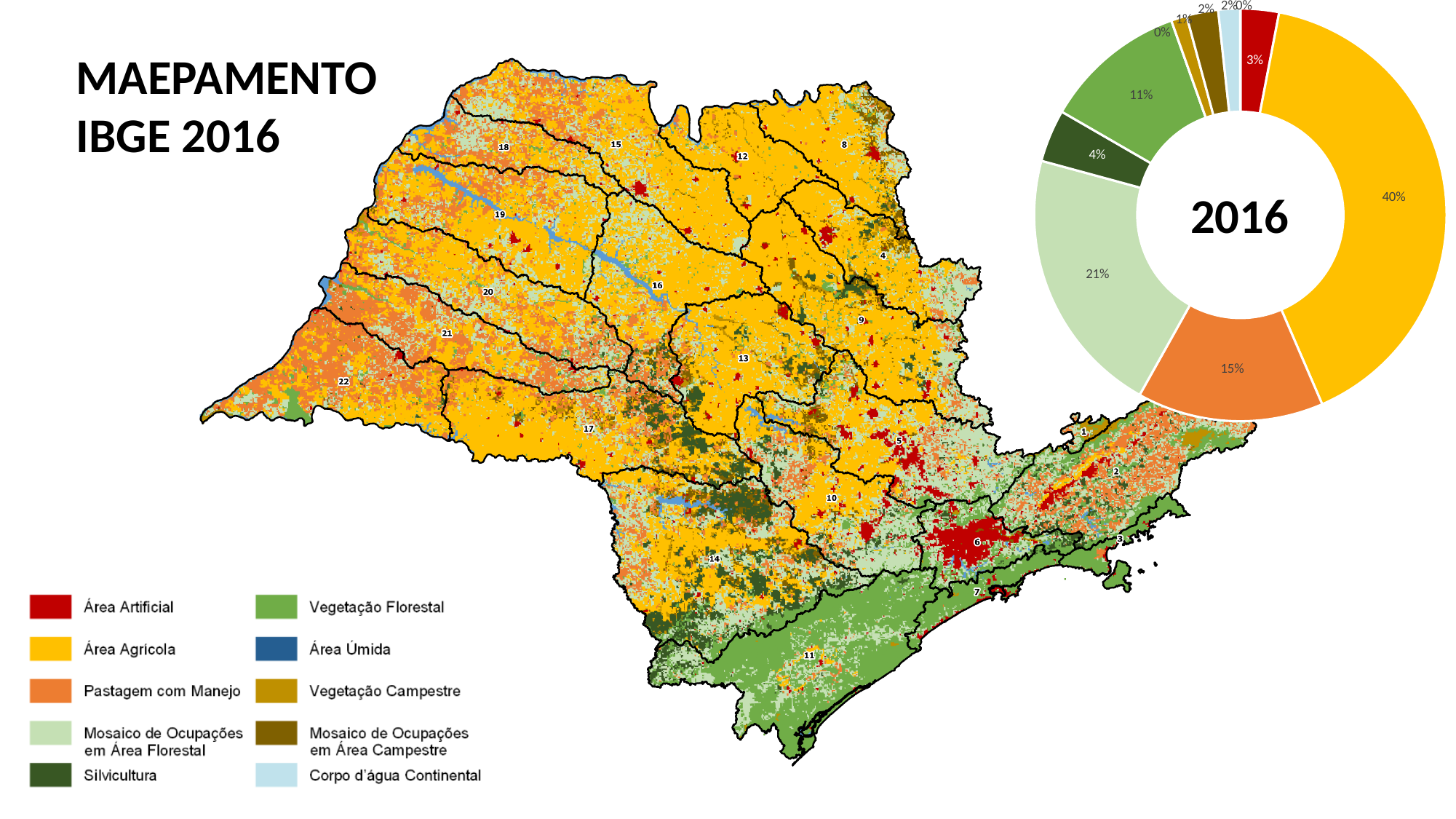
In the doughnut chart, what is the difference between the yellow slice (40%) and the light green slice (21%)? 19 percentage points What is the title text shown at the top-left of the slide? MAEPAMENTO IBGE 2016 What text is displayed in the centre of the doughnut chart? 2016 What kind of chart is shown in the top-right corner of the slide? Doughnut (pie) chart In the doughnut chart, what percentage is shown for the dark green slice (Silvicultura)? 4% In the doughnut chart, what percentage is shown for the orange slice (Pastagem com Manejo)? 15% In the doughnut chart, what percentage is shown for the yellow slice (Área Agrícola)? 40% In the doughnut chart, what percentage is shown for the red slice (Área Artificial)? 3% In the doughnut chart, what percentage is shown for the light green slice (Mosaico de Ocupações em Área Florestal)? 21% In the doughnut chart, what is the value of the largest slice? 40% In the doughnut chart, what percentage is shown for the medium green slice (Vegetação Florestal)? 11% In the doughnut chart, which slice is larger: the orange slice (Pastagem com Manejo) or the medium green slice (Vegetação Florestal)? The orange slice (Pastagem com Manejo)